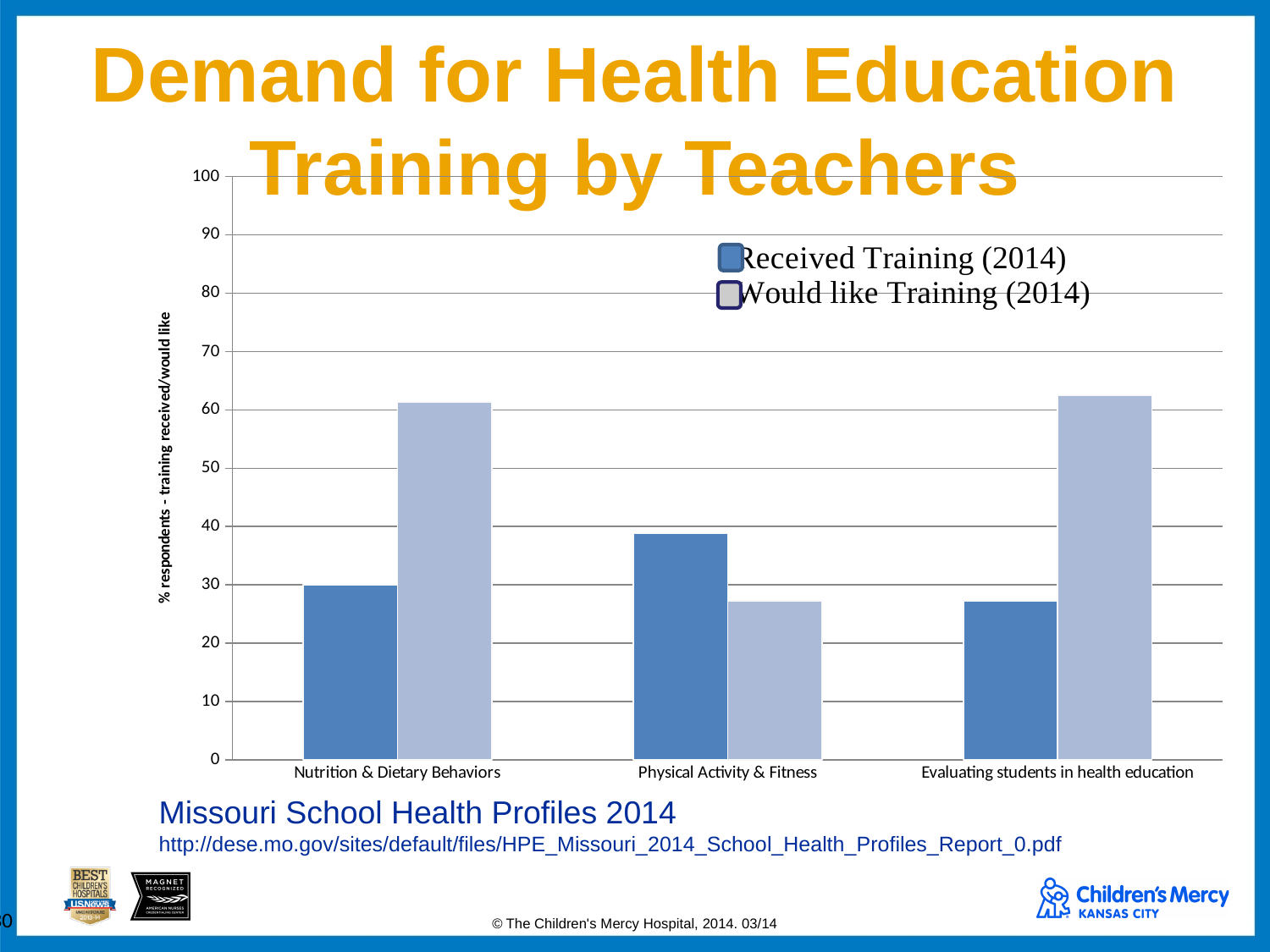
What kind of chart is shown on the slide? bar chart Is the Would like Training (2014) value for Nutrition & Dietary Behaviors greater or less than 50? greater Is the Received Training (2014) value for Nutrition & Dietary Behaviors greater or less than 40? less For Physical Activity & Fitness, which is larger: Received Training (2014) or Would like Training (2014)? Received Training (2014) Which category has the lowest value for Would like Training (2014)? Physical Activity & Fitness For Evaluating students in health education, which is larger: Received Training (2014) or Would like Training (2014)? Would like Training (2014) Is the Received Training (2014) value for Physical Activity & Fitness greater or less than 30? greater What is the label on the vertical axis of the chart? % respondents - training received/would like How many categories are shown on the x axis? 3 How many series does the legend list? 2 Which category has the highest value for Received Training (2014)? Physical Activity & Fitness